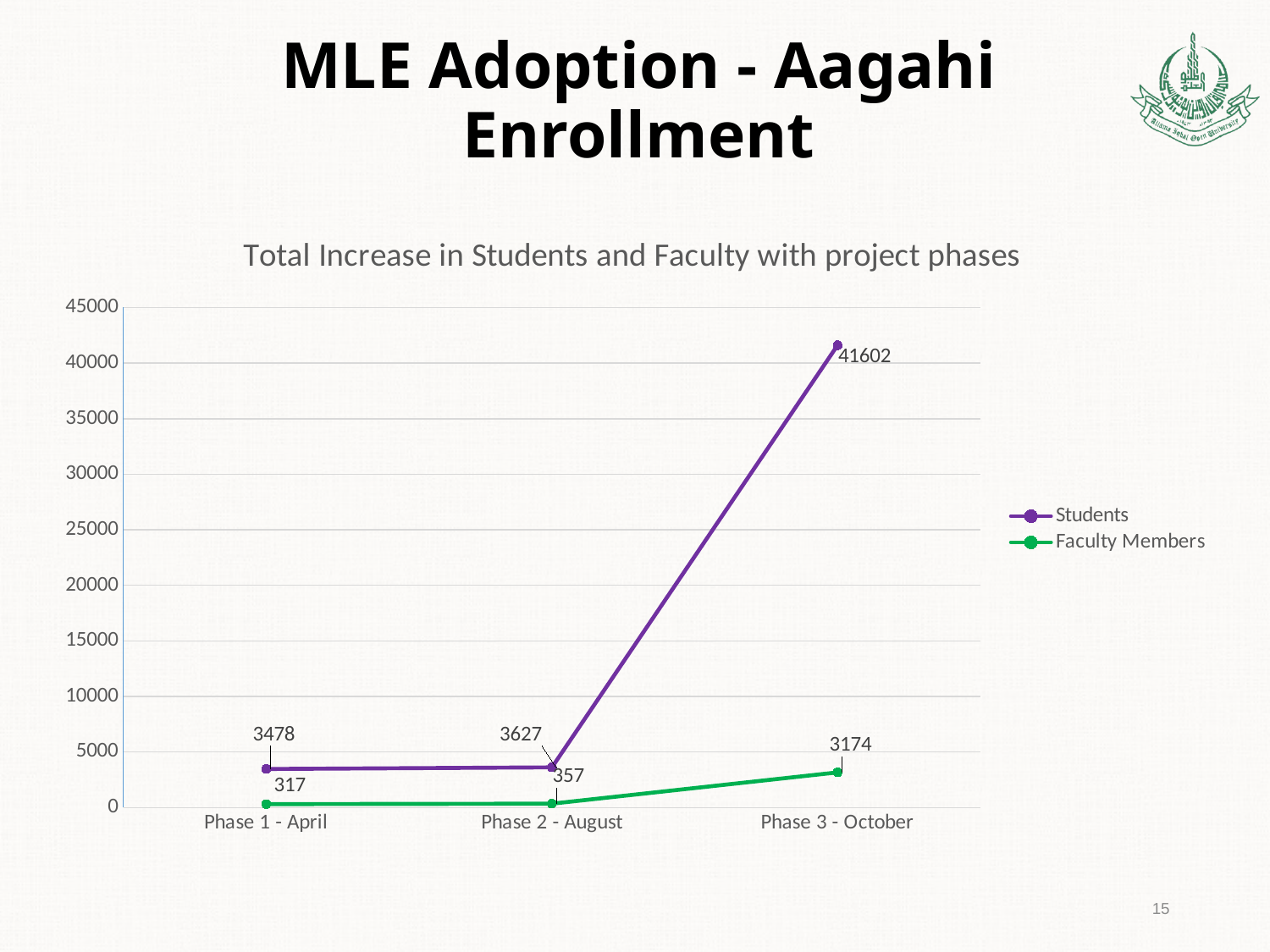
Is the value for Students in Phase 3 - October greater or less than 40000? greater What is the value for Students in Phase 3 - October? 41602 In which phase is the Students value highest? Phase 3 - October What is the value for Faculty Members in Phase 3 - October? 3174 What is the value for Faculty Members in Phase 1 - April? 317 What is the value for Students in Phase 2 - August? 3627 How many series does the legend list? 2 What is the difference between the Students values in Phase 3 - October and Phase 2 - August? 37975 Which is larger in Phase 2 - August: Students or Faculty Members? Students What kind of chart is shown? line chart In which phase is the Faculty Members value lowest? Phase 1 - April How many phases are shown on the x axis? 3